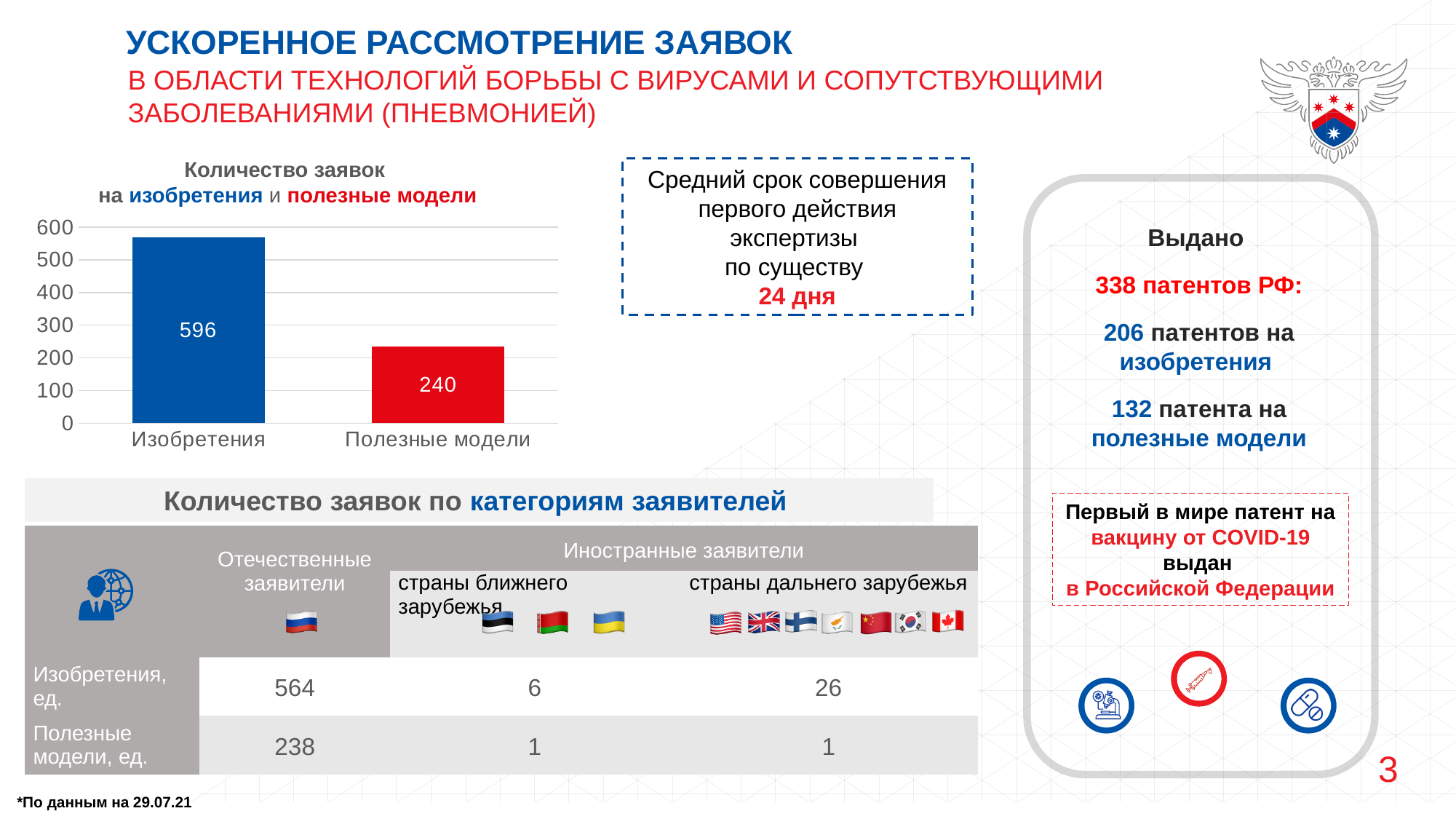
What kind of chart is shown on the slide? bar chart Is the value for Изобретения greater or less than 500? greater What is the title of the bar chart? Количество заявок на изобретения и полезные модели Which category has the lowest value in the bar chart? Полезные модели What is the difference between the values for Изобретения and Полезные модели in the bar chart? 356 Is the value for Полезные модели greater or less than 300? less Which is larger in the bar chart: Изобретения or Полезные модели? Изобретения Which category has the highest value in the bar chart? Изобретения How many categories are shown in the bar chart? 2 What is the value for Полезные модели in the bar chart? 240 What is the value for Изобретения in the bar chart? 596 What colour is the bar for Полезные модели? red